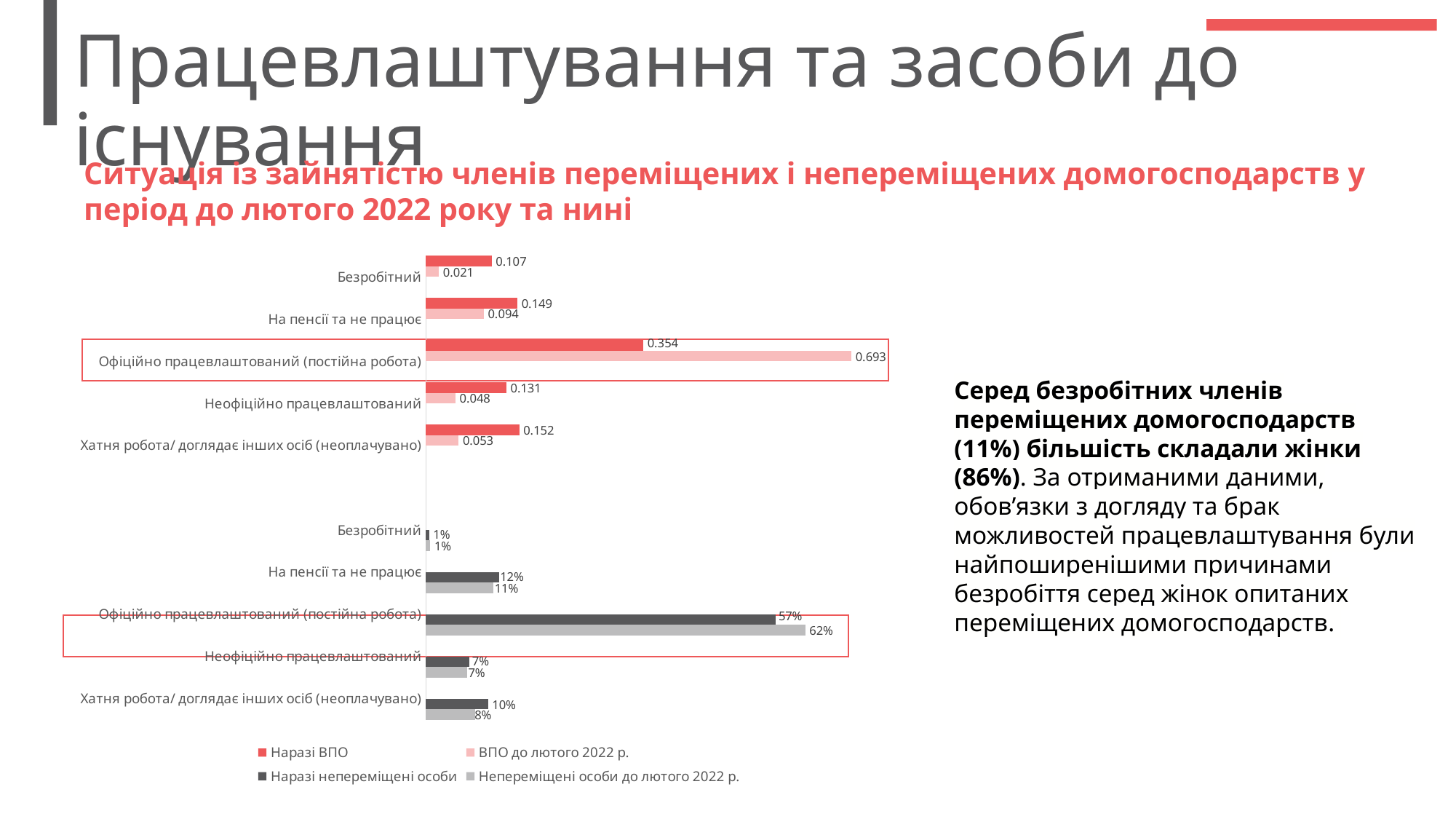
Which category has the lowest value in the "Наразі непереміщені особи" series? Безробітний What is the value for "Офіційно працевлаштований (постійна робота)" in the "ВПО до лютого 2022 р." series? 0.693 For "Безробітний", which is larger: the "Наразі ВПО" value or the "ВПО до лютого 2022 р." value? Наразі ВПО What is the value for "Безробітний" in the "Наразі ВПО" series? 0.107 How many series does the legend list? 4 What is the value for "Офіційно працевлаштований (постійна робота)" in the "Наразі непереміщені особи" series? 57% What is the difference between the "Непереміщені особи до лютого 2022 р." and "Наразі непереміщені особи" values for "Офіційно працевлаштований (постійна робота)"? 5% What is the value for "Хатня робота/ доглядає інших осіб (неоплачувано)" in the "Непереміщені особи до лютого 2022 р." series? 8% Which category has the highest value in the "ВПО до лютого 2022 р." series? Офіційно працевлаштований (постійна робота) What is the value for "Офіційно працевлаштований (постійна робота)" in the "Наразі ВПО" series? 0.354 What kind of chart is shown on the slide? Bar chart What is the difference between the "ВПО до лютого 2022 р." and "Наразі ВПО" values for "Офіційно працевлаштований (постійна робота)"? 0.339